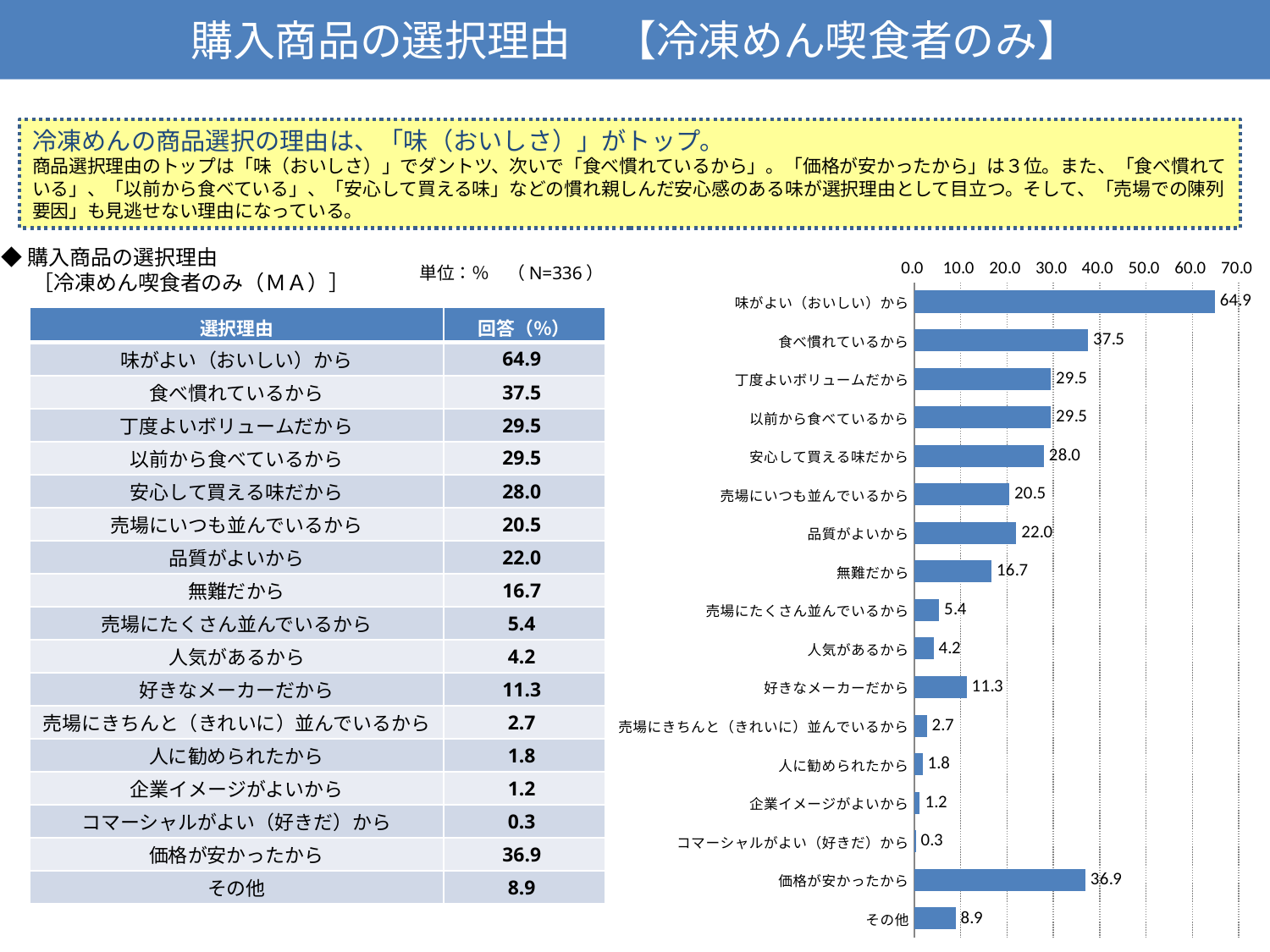
Which category has the lowest value in the bar chart? コマーシャルがよい（好きだ）から What is the difference between the values for 品質がよいから and 売場にいつも並んでいるから? 1.5 What value is shown for 価格が安かったから in the bar chart? 36.9 Which is larger, the value for 食べ慣れているから or the value for 価格が安かったから? 食べ慣れているから Which category has the highest value in the bar chart? 味がよい（おいしい）から What is the maximum value shown on the chart's horizontal axis? 70.0 What kind of chart is shown on the slide? bar chart What is the difference between the values for 味がよい（おいしい）から and 食べ慣れているから? 27.4 What value is shown for 味がよい（おいしい）から in the bar chart? 64.9 What value is shown for 好きなメーカーだから in the bar chart? 11.3 How many categories are plotted in the bar chart? 17 Is the value for 無難だから greater or less than 20.0? less